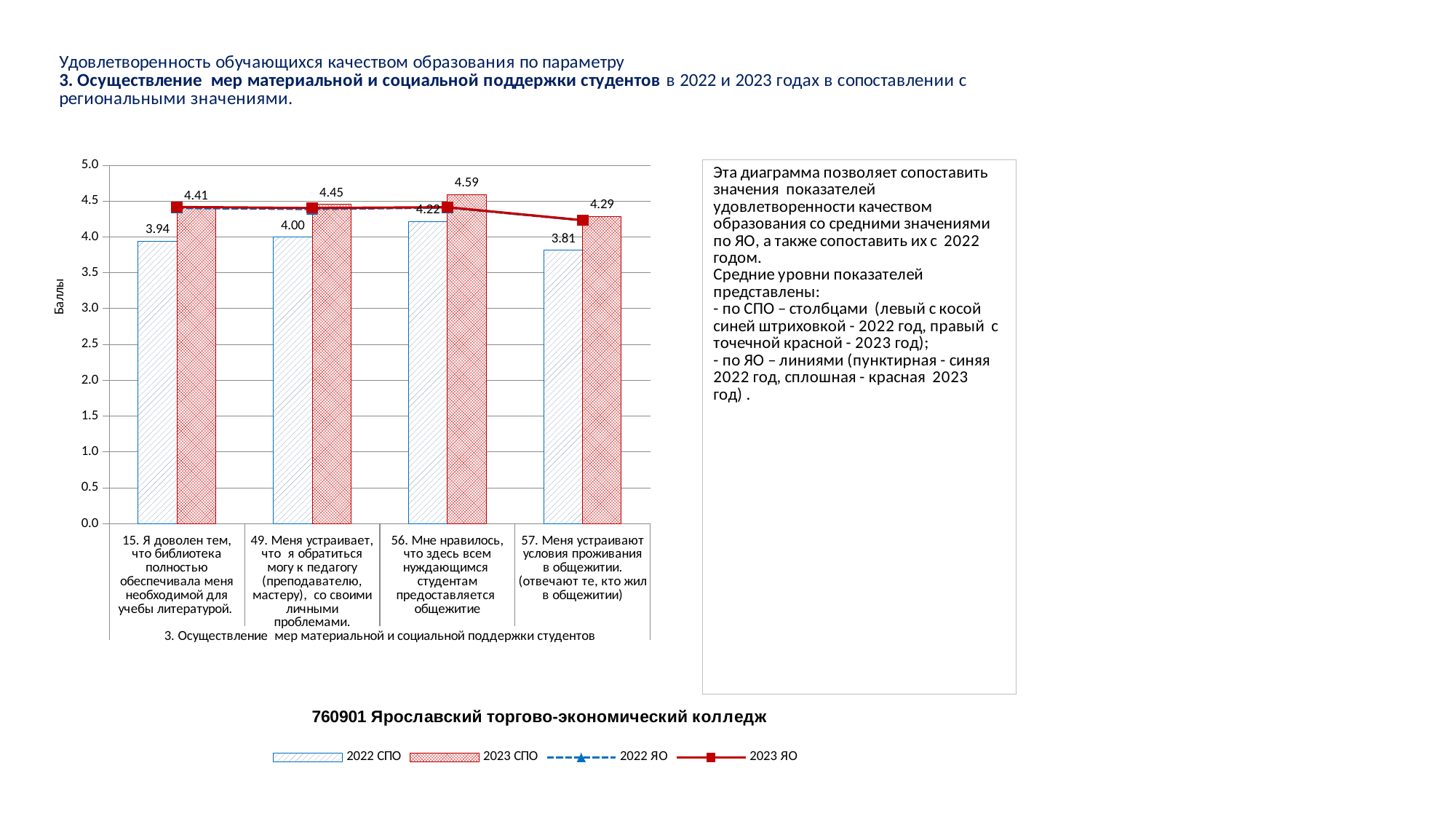
What is the 2023 СПО value for item 57 (Меня устраивают условия проживания в общежитии)? 4.29 Which item has the highest 2023 СПО value? 56. Мне нравилось, что здесь всем нуждающимся студентам предоставляется общежитие What is the 2023 СПО value for item 15 (Я доволен тем, что библиотека полностью обеспечивала меня необходимой для учебы литературой)? 4.41 What is the difference between the 2023 СПО and 2022 СПО values for item 49 (Меня устраивает, что я обратиться могу к педагогу)? 0.45 For item 57, which is larger: the 2022 СПО value or the 2023 СПО value? 2023 СПО Which item has the lowest 2022 СПО value? 57. Меня устраивают условия проживания в общежитии How many survey items (categories) are shown on the x axis? 4 How many series does the legend list? 4 What kind of chart is shown on the slide? Combined bar and line chart Is the 2023 ЯО value for item 57 greater or less than 4.0? greater What is the 2022 СПО value for item 56 (Мне нравилось, что здесь всем нуждающимся студентам предоставляется общежитие)? 4.22 What is the label of the y axis? Баллы